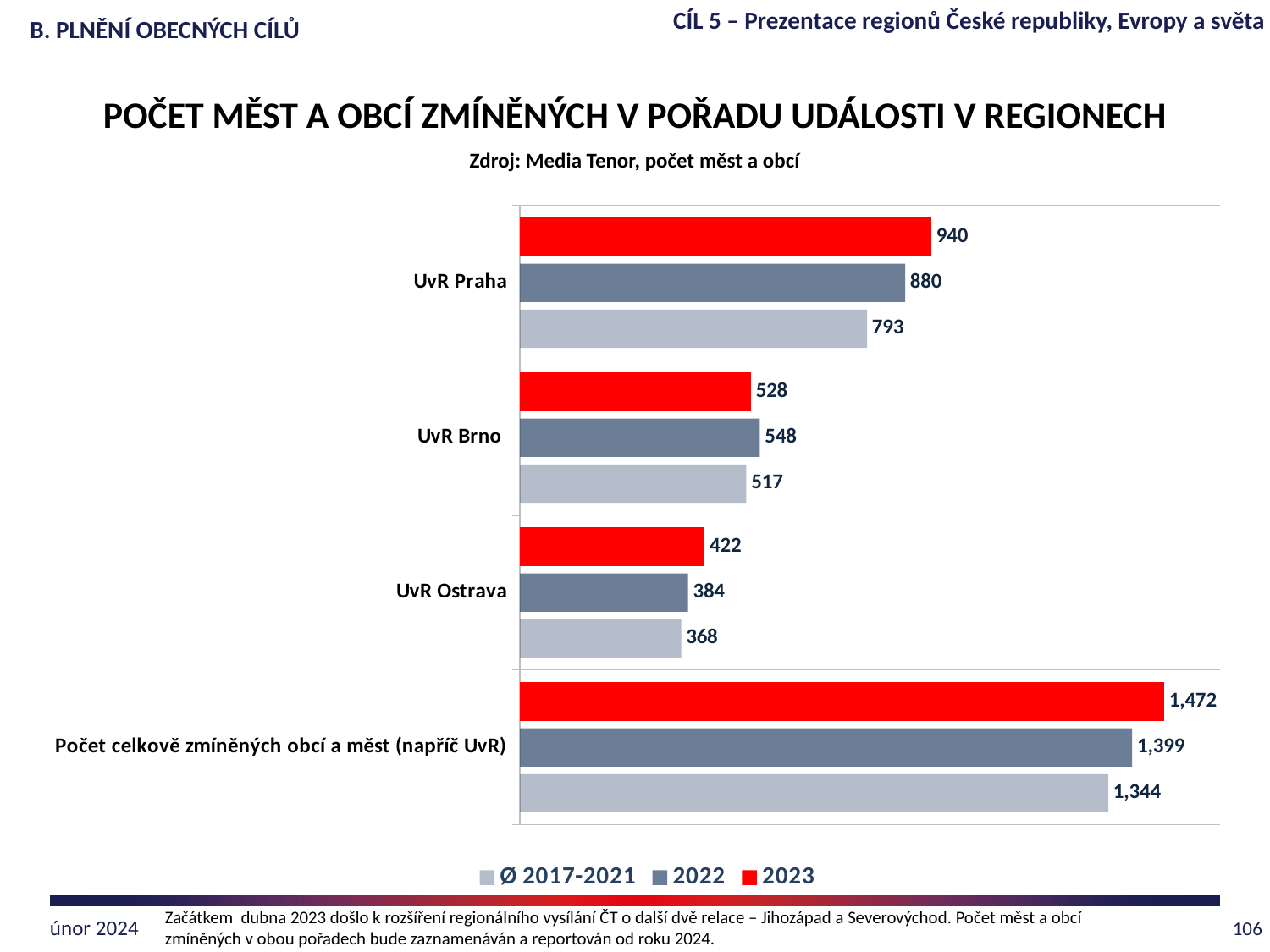
Among the three UvR categories, which has the lowest Ø 2017-2021 value? UvR Ostrava How many series does the legend list? 3 What is the 2023 value for UvR Praha? 940 What kind of chart is shown on the slide? bar chart How many categories are shown on the chart? 4 Which colour represents the 2023 series in the legend? red What is the 2022 value for UvR Brno? 548 Which category has the highest 2023 value? Počet celkově zmíněných obcí a měst (napříč UvR) What is the 2023 value for Počet celkově zmíněných obcí a měst (napříč UvR)? 1,472 What is the Ø 2017-2021 value for UvR Ostrava? 368 For UvR Brno, which is larger: the 2022 value or the 2023 value? 2022 What is the difference between the 2023 and 2022 values for UvR Praha? 60